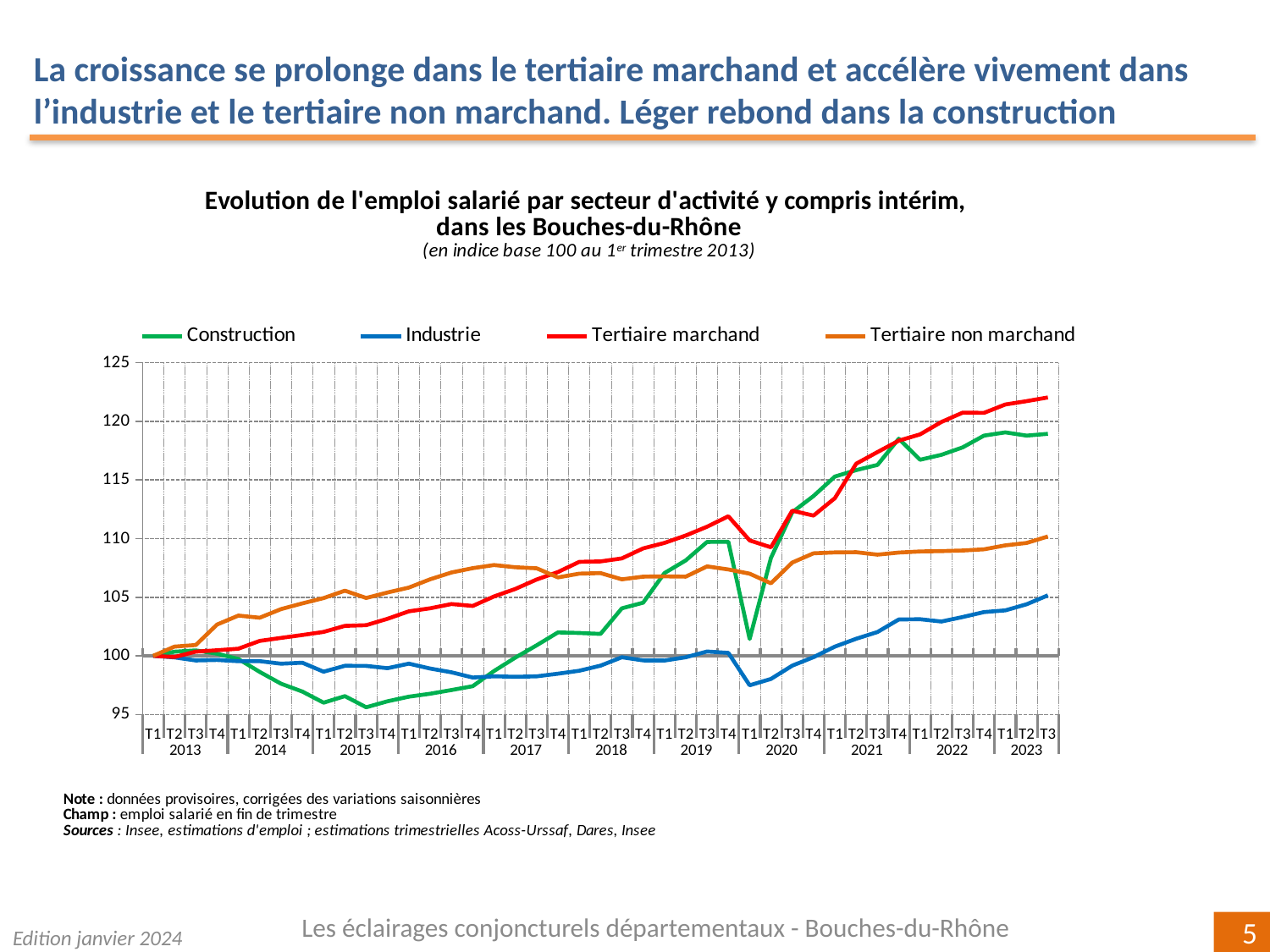
What is the index value of all series at T1 2013? 100 Is the value for Tertiaire non marchand at T3 2023 greater or less than 105? greater How many series does the legend list? 4 Is the value for Industrie at T1 2020 greater or less than 100? less Which series is highest at T3 2023? Tertiaire marchand At T3 2023, which is higher: Construction or Tertiaire non marchand? Construction Is the value for Construction at T1 2015 greater or less than 100? less Which colour represents the Industrie series in the legend? blue Which series is lowest at T3 2023? Industrie What kind of chart is shown on the slide? line chart Does the Tertiaire marchand series rise or fall overall from T1 2013 to T3 2023? rise